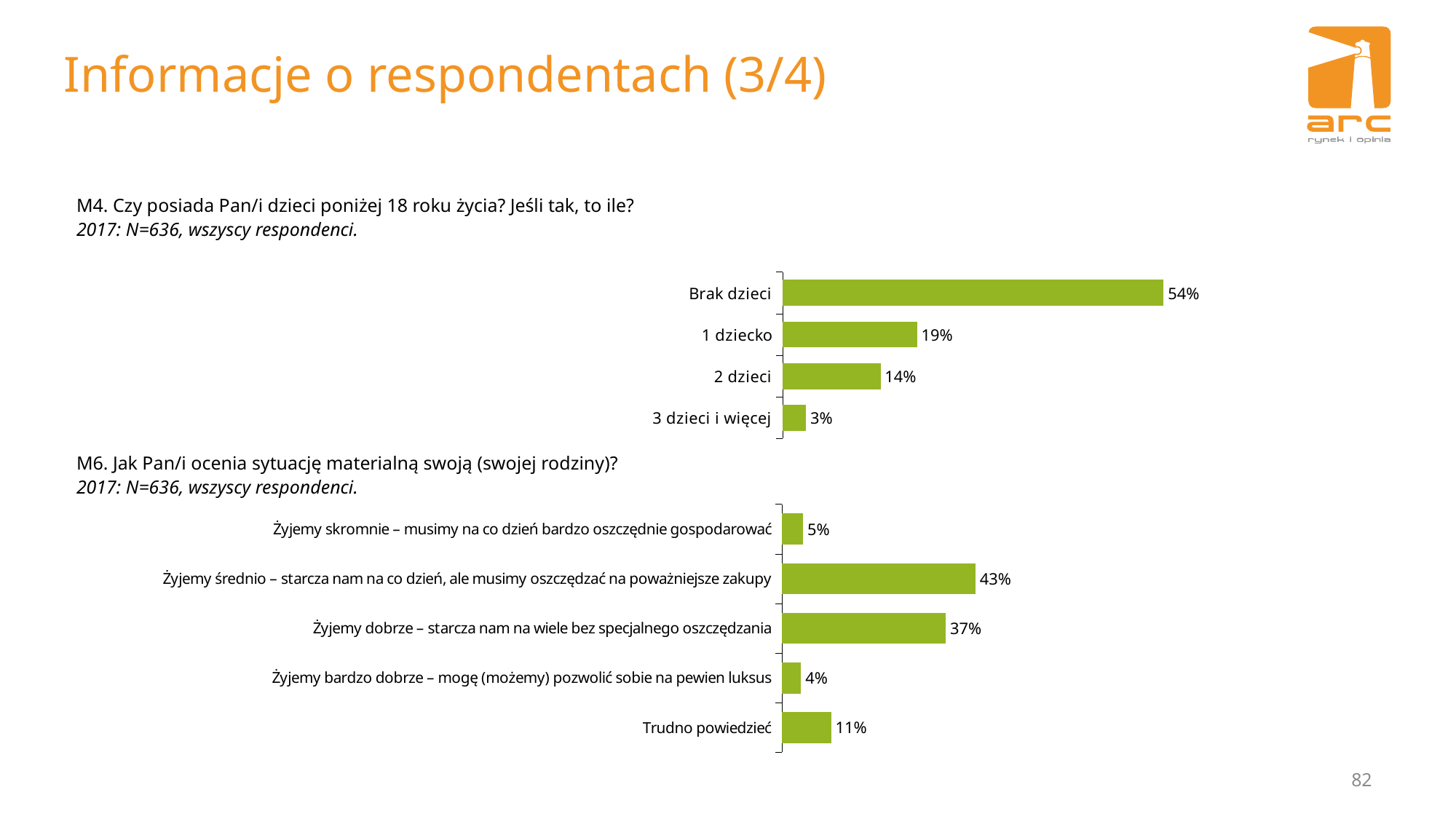
In the M4 chart (top), what percentage of respondents have no children (Brak dzieci)? 54% In the M6 chart (bottom), what is the value for 'Żyjemy średnio – starcza nam na co dzień, ale musimy oszczędzać na poważniejsze zakupy'? 43% In the M6 chart (bottom), what percentage answered 'Trudno powiedzieć'? 11% In the M4 chart (top), what is the value for '1 dziecko'? 19% In the M4 chart (top), what is the difference between '1 dziecko' and '2 dzieci'? 5% In the M6 chart (bottom), how many categories are shown? 5 In the M4 chart (top), how many categories are shown? 4 In the M6 chart (bottom), which is larger: 'Żyjemy skromnie' or 'Żyjemy bardzo dobrze'? Żyjemy skromnie In the M6 chart (bottom), what is the difference between 'Żyjemy średnio' and 'Żyjemy dobrze'? 6% What type of chart is used for the M4 question on the slide? Bar chart In the M4 chart (top), which category has the lowest value? 3 dzieci i więcej In the M6 chart (bottom), which category has the highest value? Żyjemy średnio – starcza nam na co dzień, ale musimy oszczędzać na poważniejsze zakupy